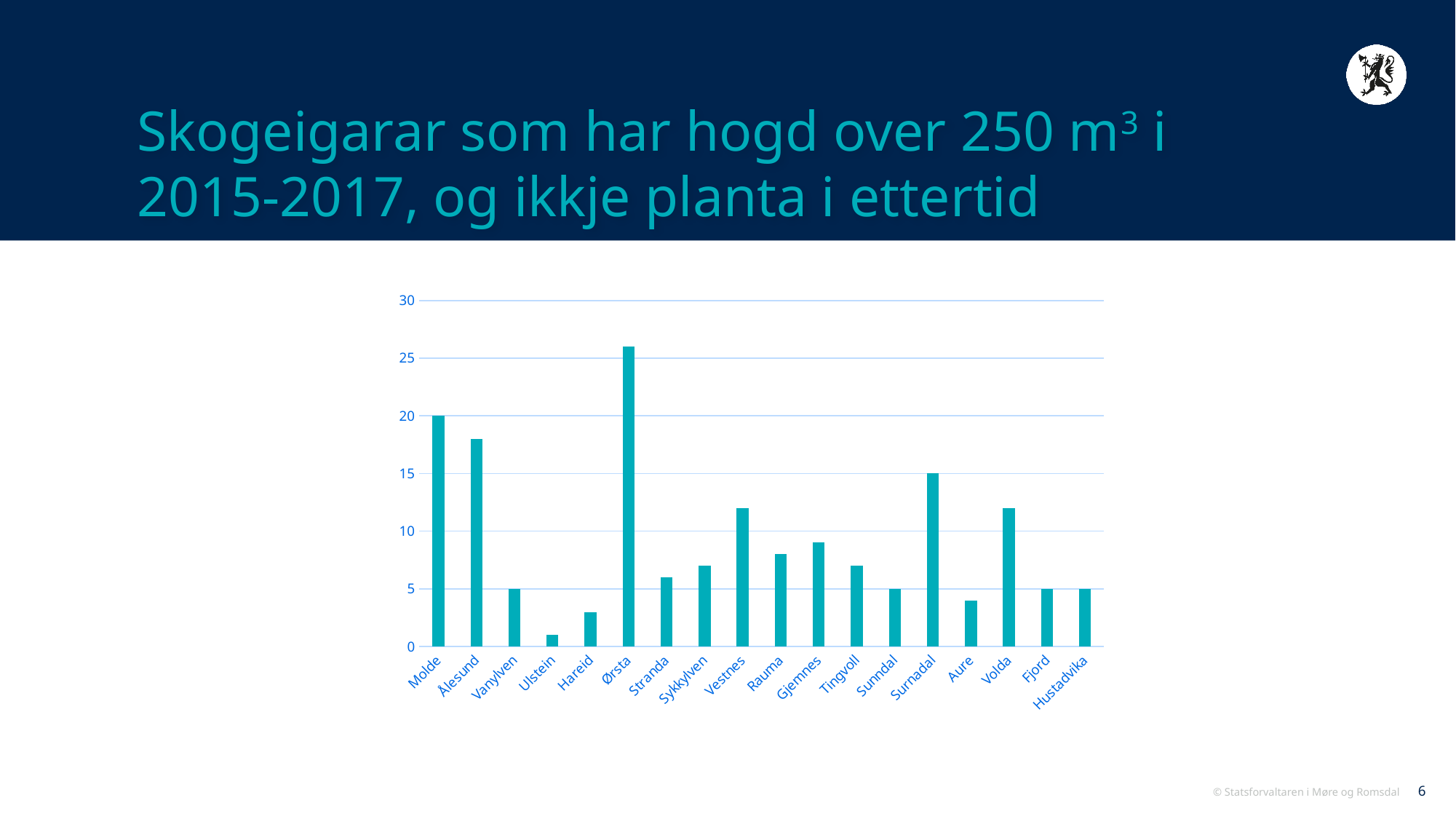
Which municipality has the highest value in the chart? Ørsta What kind of chart is shown on the slide? bar chart Which is larger, the value for Molde or the value for Ålesund? Molde What is the value for Surnadal? 15 Is the value for Ørsta greater or less than 25? greater Is the value for Ålesund greater or less than 15? greater Is the value for Hareid greater or less than 5? less How many municipalities are shown on the x axis of the chart? 18 What is the value for Molde? 20 Which municipality has the lowest value in the chart? Ulstein What is the value for Vanylven? 5 What is the difference between the values for Molde and Surnadal? 5